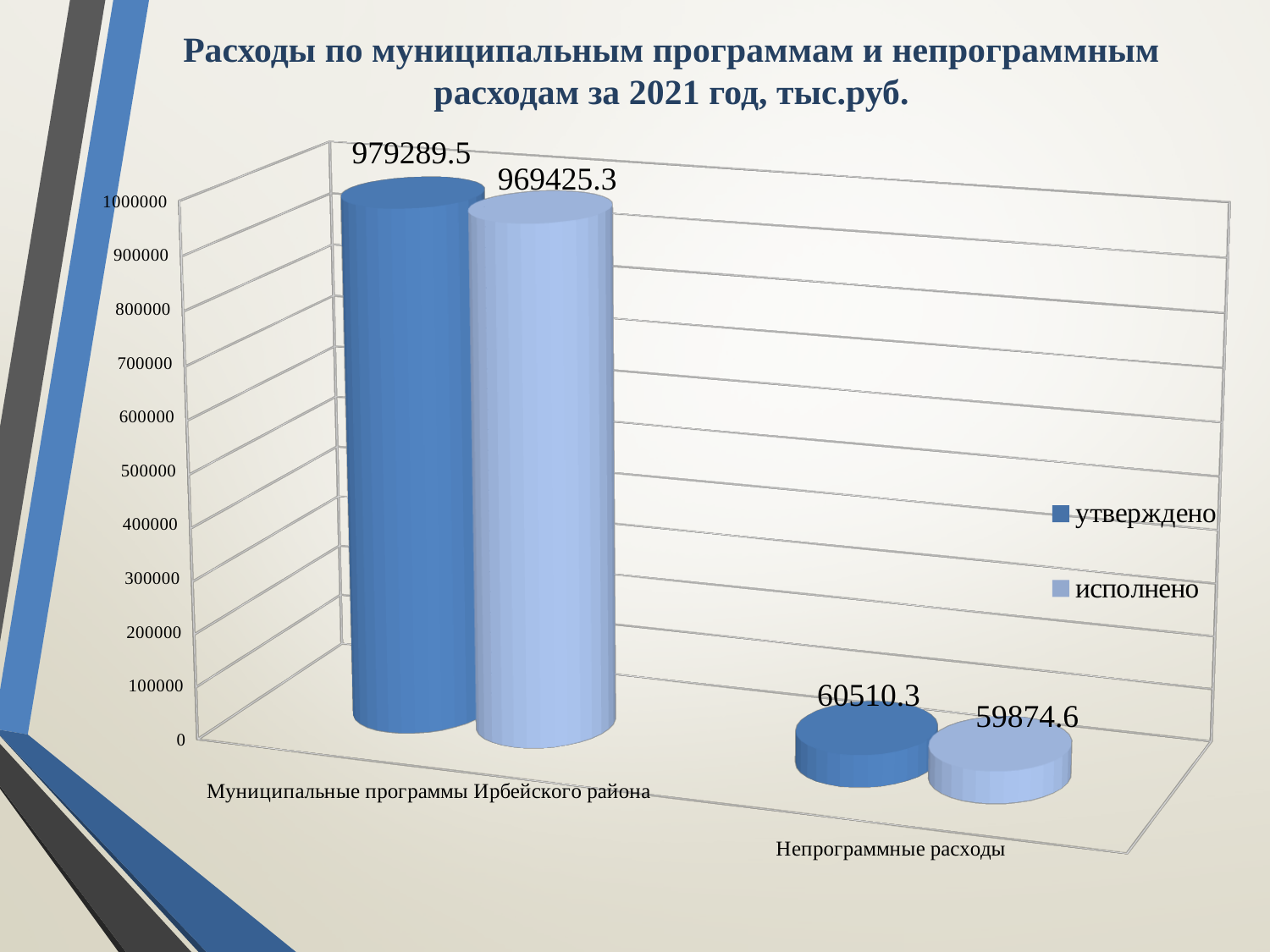
Which category has the highest approved (утверждено) value? Муниципальные программы Ирбейского района What is the approved (утверждено) value for Непрограммные расходы? 60510.3 Which is larger: the approved value for Муниципальные программы Ирбейского района or the approved value for Непрограммные расходы? Муниципальные программы Ирбейского района What is the executed (исполнено) value for Муниципальные программы Ирбейского района? 969425.3 Which category has the lowest executed (исполнено) value? Непрограммные расходы What kind of chart is shown on the slide? Bar chart What is the difference between the approved and executed values for Муниципальные программы Ирбейского района? 9864.2 How many categories are shown on the x axis? 2 What is the difference between the approved and executed values for Непрограммные расходы? 635.7 How many series does the legend list? 2 What is the executed (исполнено) value for Непрограммные расходы? 59874.6 What is the approved (утверждено) value for Муниципальные программы Ирбейского района? 979289.5